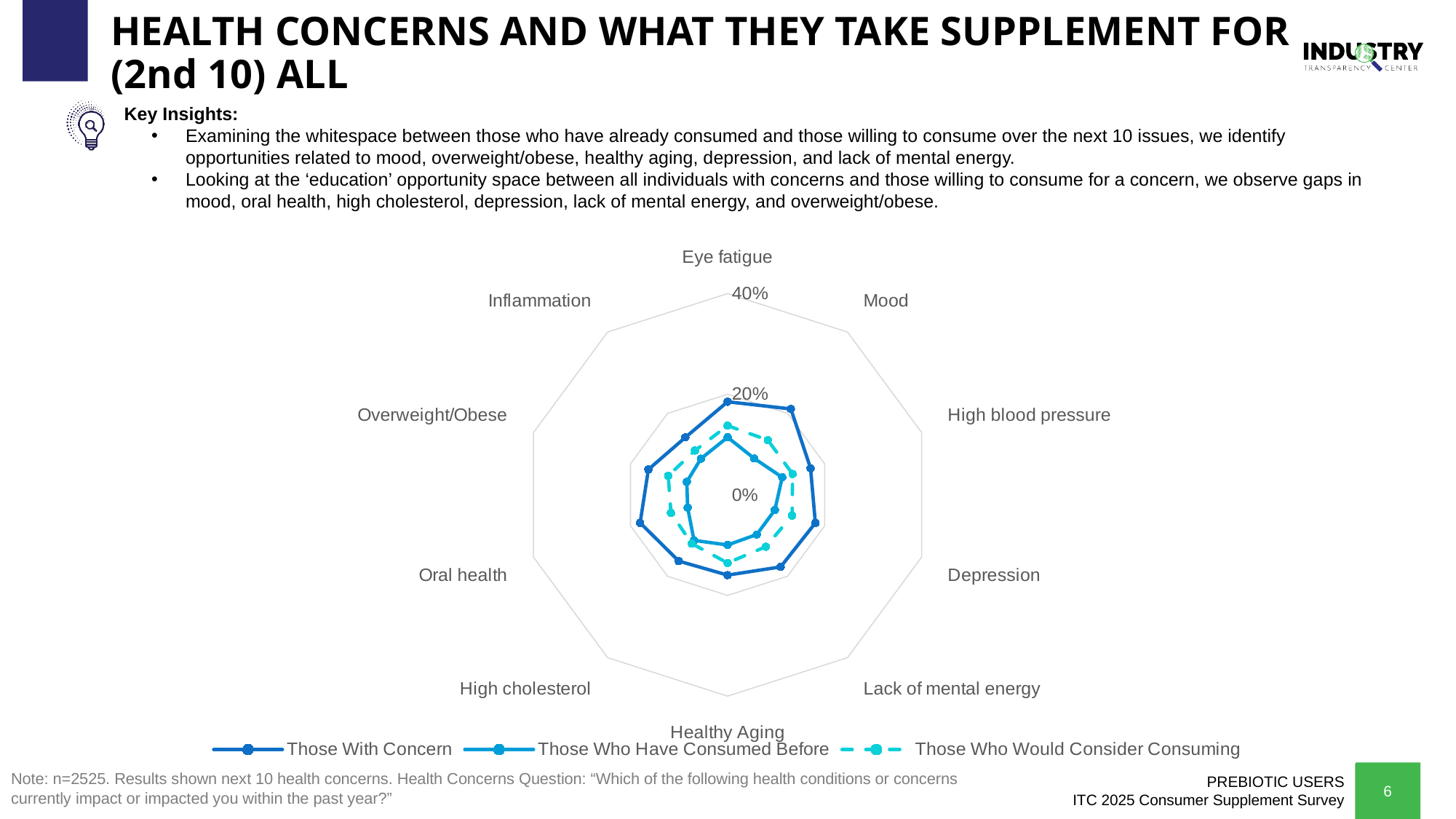
Is the value for Depression in the 'Those With Concern' series greater or less than 40%? less Is the value for Eye fatigue in the 'Those Who Have Consumed Before' series greater or less than 20%? less For Oral health, which series has the larger value: 'Those With Concern' or 'Those Who Would Consider Consuming'? Those With Concern What kind of chart is shown on the slide? Radar chart For Mood, which series has the larger value: 'Those Who Would Consider Consuming' or 'Those Who Have Consumed Before'? Those Who Would Consider Consuming For Eye fatigue, which series has the larger value: 'Those With Concern' or 'Those Who Have Consumed Before'? Those With Concern How many health concern categories are plotted on the radar chart? 10 Is the value for Healthy Aging in the 'Those Who Would Consider Consuming' series greater or less than 20%? less How many series does the legend of the radar chart list? 3 Which series is plotted with a dashed line on the radar chart? Those Who Would Consider Consuming What is the highest percentage tick shown on the radar chart's axis? 40%